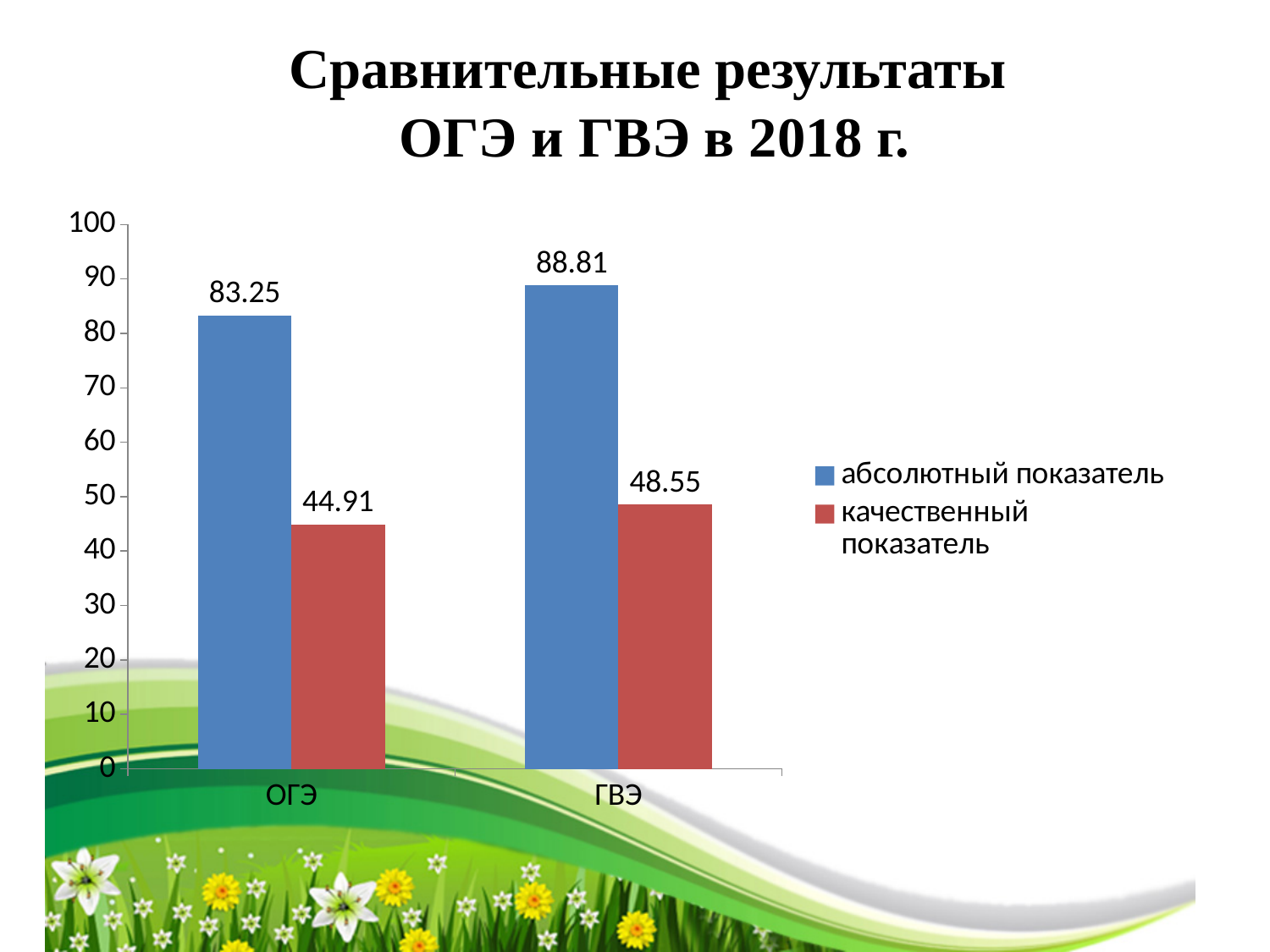
What is the абсолютный показатель value for ОГЭ? 83.25 What is the качественный показатель value for ГВЭ? 48.55 How many series does the legend list? 2 What is the difference between the абсолютный показатель and качественный показатель for ОГЭ? 38.34 Is the качественный показатель for ГВЭ greater or less than 50? less Which category has the higher абсолютный показатель, ОГЭ or ГВЭ? ГВЭ What is the difference between the абсолютный показатель values for ГВЭ and ОГЭ? 5.56 What is the качественный показатель value for ОГЭ? 44.91 How many categories are shown on the x axis? 2 What is the абсолютный показатель value for ГВЭ? 88.81 Which category has the lowest качественный показатель? ОГЭ What kind of chart is shown on the slide? bar chart